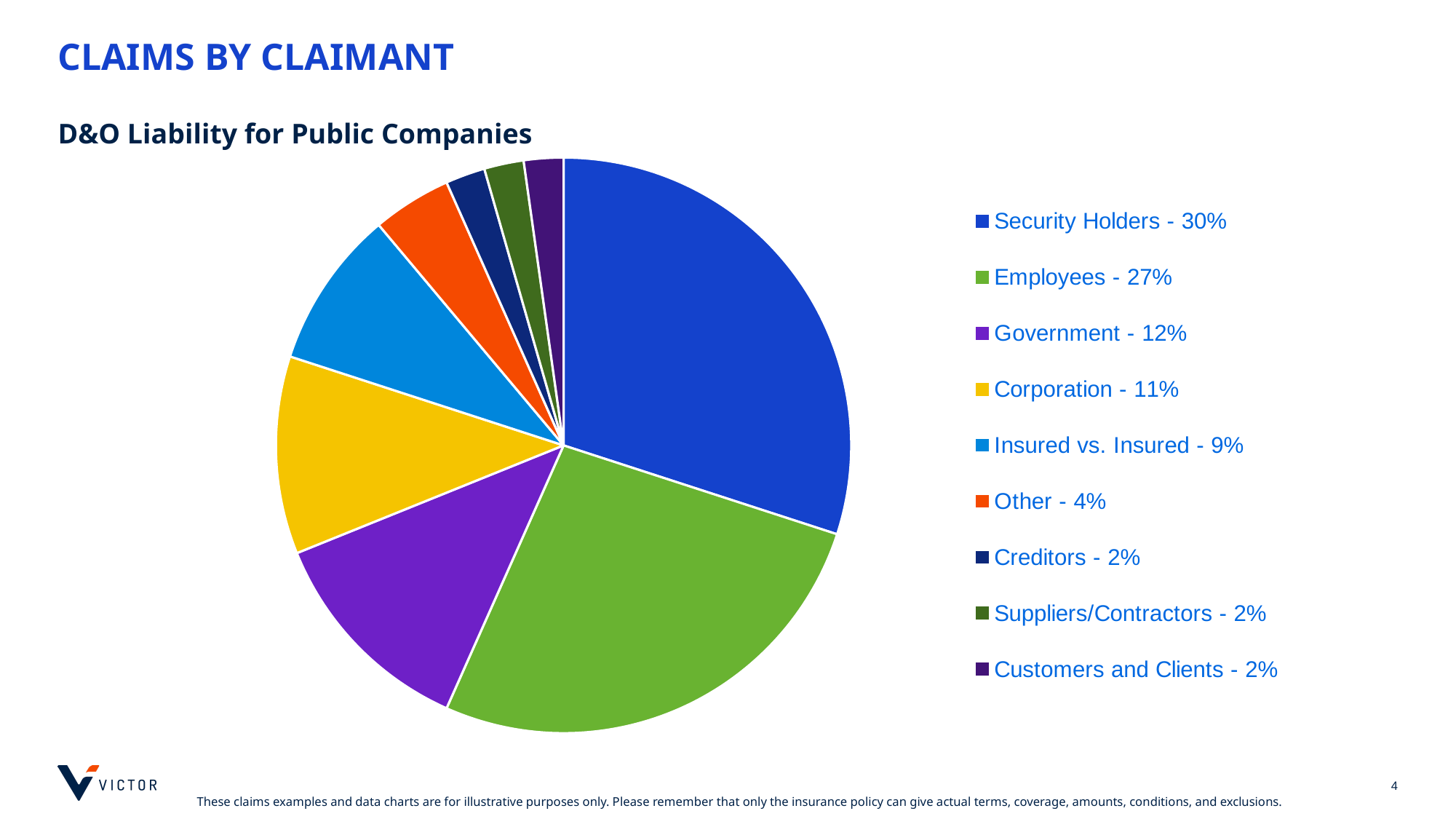
What share of claims is attributed to Security Holders? 30% What is the combined share of Security Holders and Employees? 57% What type of chart is shown on the slide? Pie chart Which claimant category has the largest share of claims? Security Holders What is the difference in percentage points between Government and Corporation? 1 What percentage of claims comes from Employees? 27% Which has a larger share of claims, Other or Government? Government What is the difference in percentage points between Security Holders and Employees? 3 How many claimant categories are shown in the pie chart? 9 Which has a larger share of claims, Corporation or Insured vs. Insured? Corporation What is the subtitle of the chart? D&O Liability for Public Companies What is the value shown for Insured vs. Insured? 9%